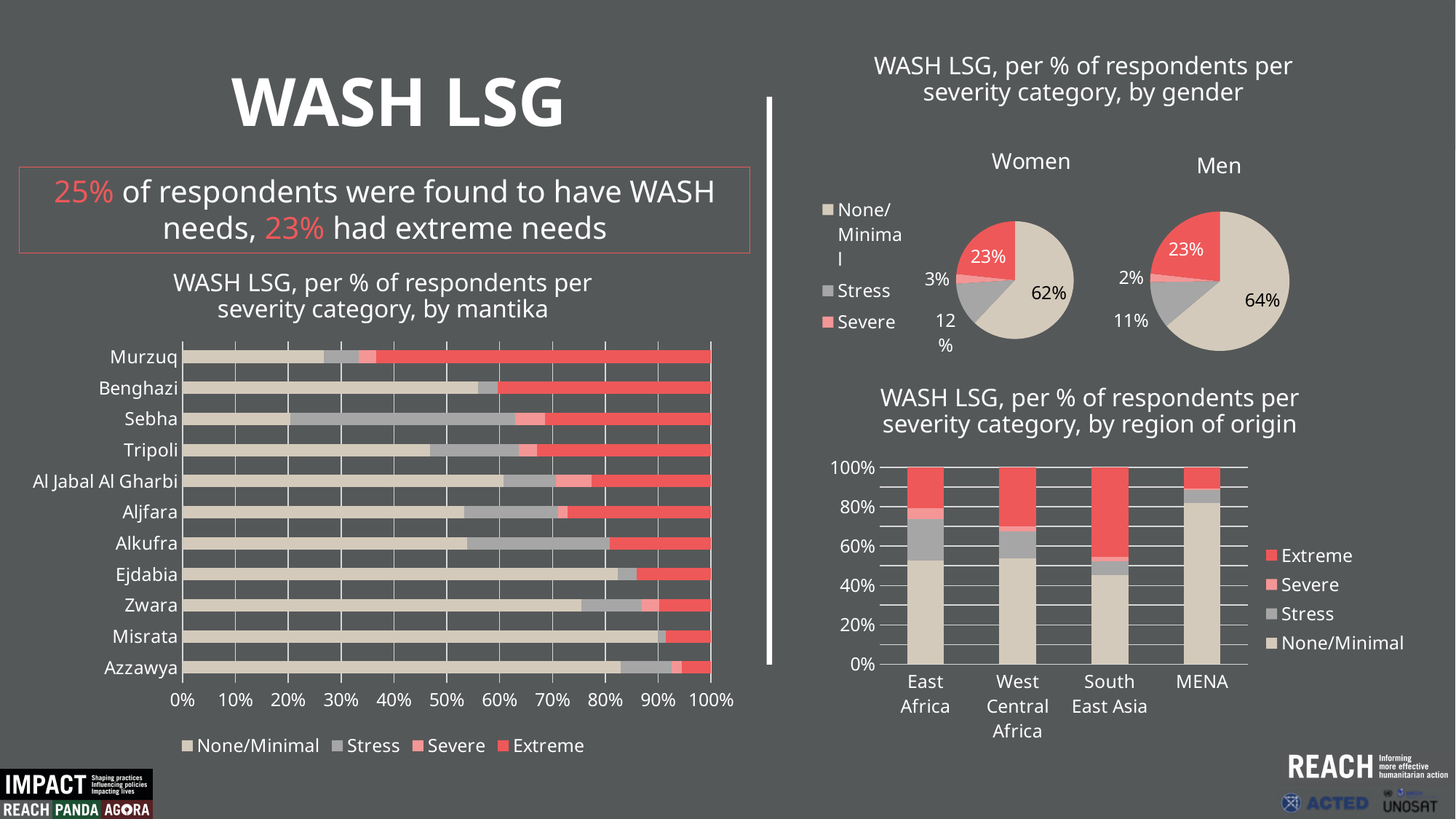
In the gender pie charts, what percentage of women fall in the None/Minimal category? 62% In the chart by mantika, which mantika has the smallest None/Minimal share? Sebha In the chart 'WASH LSG, per % of respondents per severity category, by mantika', how many mantikas are shown? 11 In the gender pie charts, what percentage of men fall in the Stress category? 11% In the gender pie charts, which group has the larger Severe share, women or men? Women In the chart by mantika, is the None/Minimal value for Misrata greater or less than 80%? greater In the chart by mantika, how many series does the legend list? 4 In the chart 'WASH LSG, per % of respondents per severity category, by region of origin', which region has the largest None/Minimal share? MENA What kind of chart is 'WASH LSG, per % of respondents per severity category, by mantika'? Stacked bar chart In the chart by mantika, which mantika has the largest Extreme share? Murzuq In the gender pie charts, what is the difference between the None/Minimal share for men and for women? 2 percentage points In the chart by region of origin, is the None/Minimal value for South East Asia greater or less than 60%? less